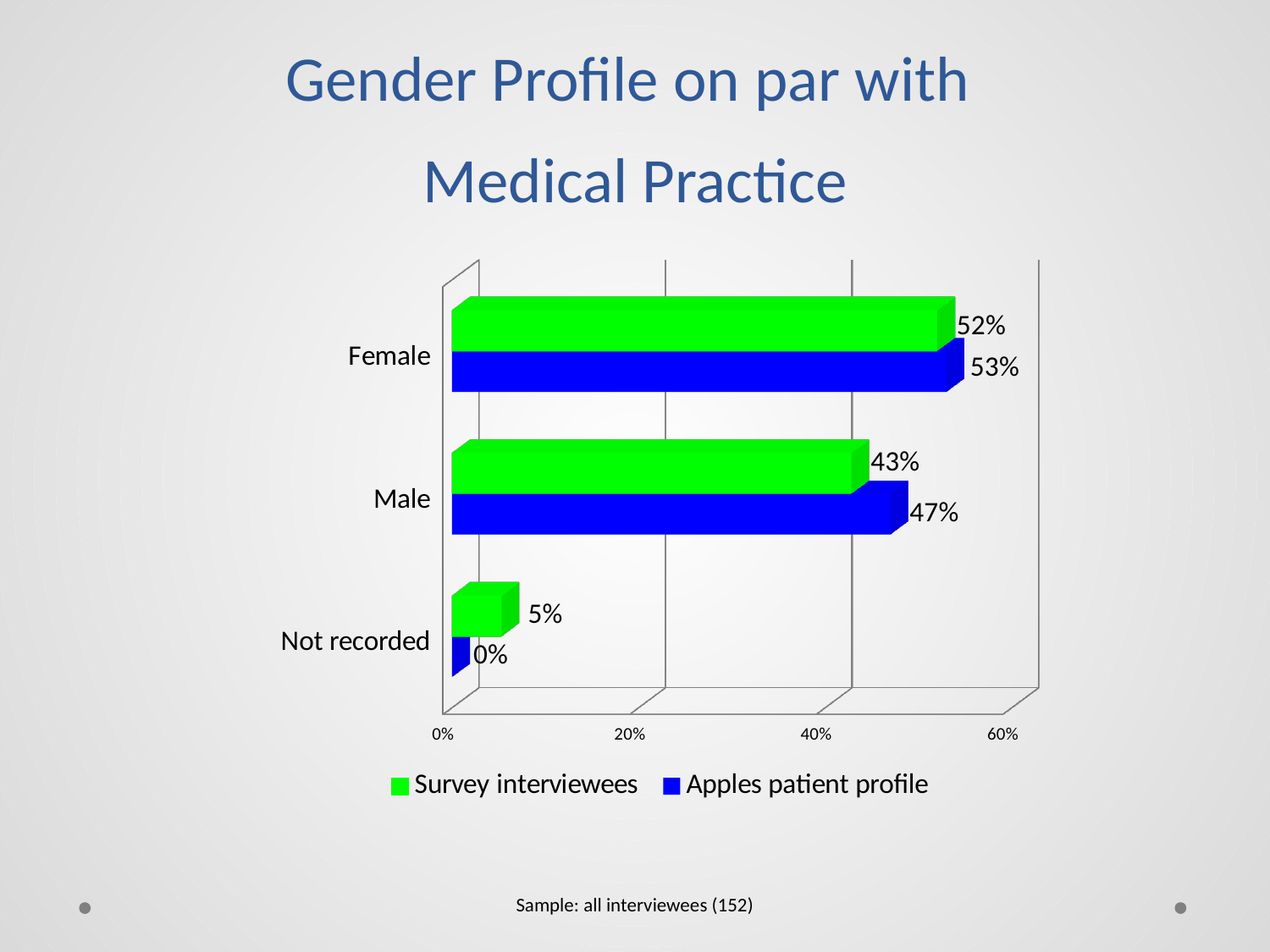
What kind of chart is shown on the slide? Bar chart How many series does the legend list? 2 Which category has the highest value in the Apples patient profile series? Female Which category has the lowest value in the Survey interviewees series? Not recorded What is the value for Not recorded in the Apples patient profile series? 0% What is the value for Not recorded in the Survey interviewees series? 5% What is the value for Female in the Survey interviewees series? 52% How many categories are shown on the chart? 3 What is the value for Male in the Apples patient profile series? 47% What colour represents the Survey interviewees series? Green For Female, which series has the larger value: Survey interviewees or Apples patient profile? Apples patient profile What is the difference between the Apples patient profile and Survey interviewees values for Male? 4%